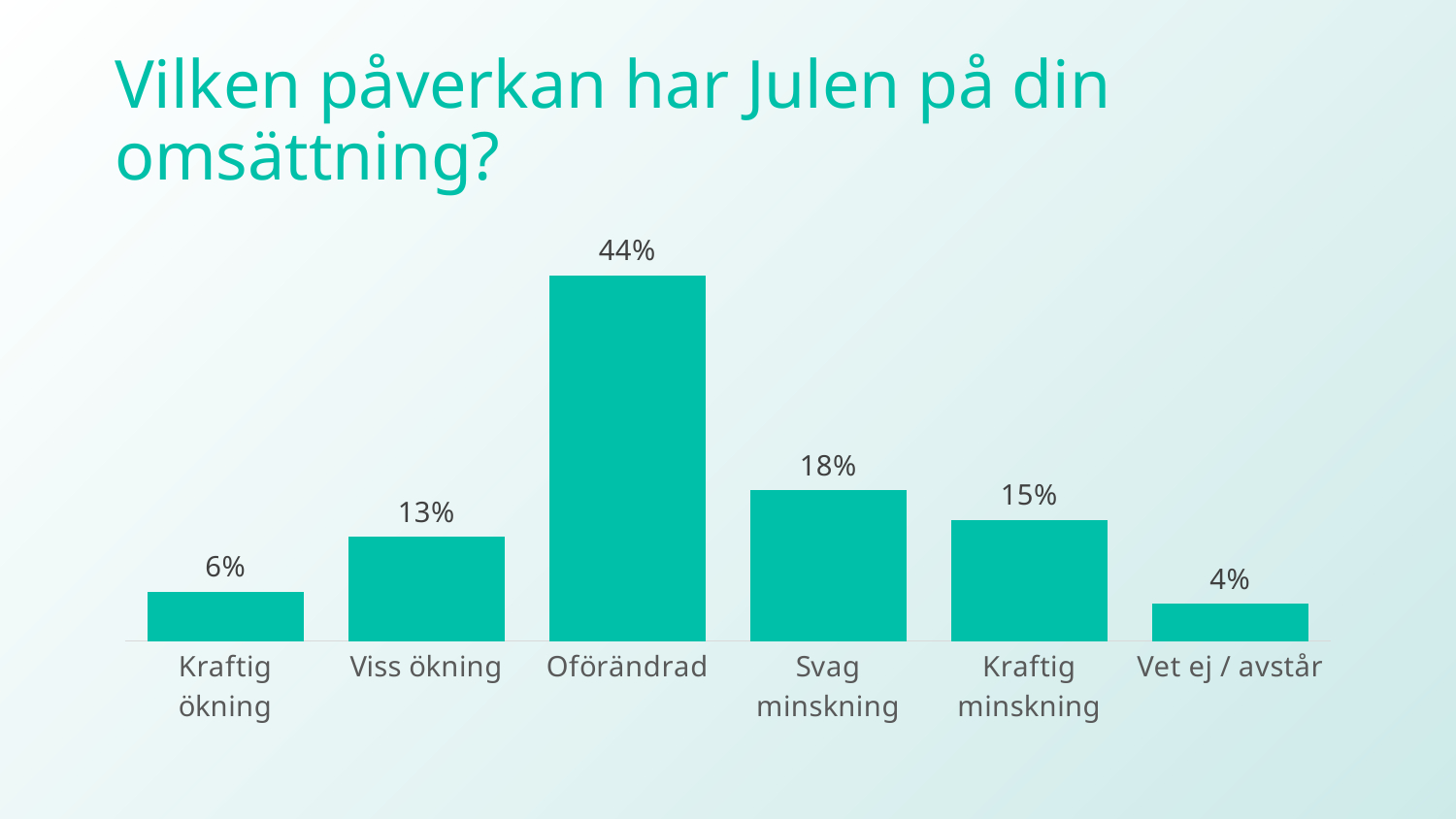
What is the value for Kraftig ökning? 6% Which category has the highest value? Oförändrad What is the value for Vet ej / avstår? 4% What kind of chart is shown on the slide? Bar chart How many categories are shown in the chart? 6 Which category has the lowest value? Vet ej / avstår What is the difference between the values for Viss ökning and Kraftig ökning? 7% What is the title of the slide? Vilken påverkan har Julen på din omsättning? What is the difference between the values for Oförändrad and Svag minskning? 26% Which is larger, the value for Svag minskning or the value for Kraftig minskning? Svag minskning What is the value for Svag minskning? 18% What is the value for Oförändrad? 44%